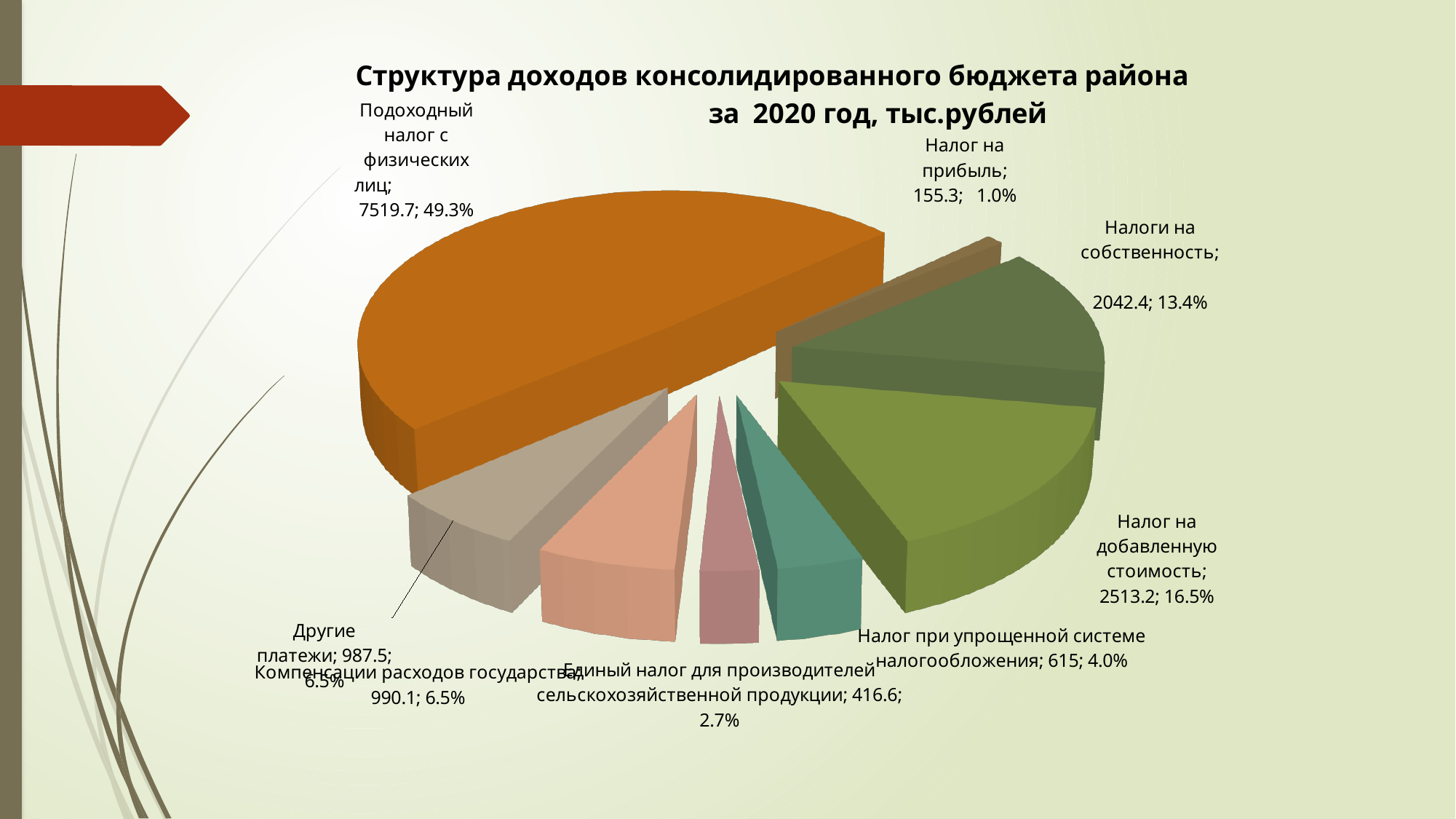
What share of the pie does Налог на прибыль take? 1.0% What is the difference between the values for Налог на добавленную стоимость and Налоги на собственность? 470.8 What share of the pie does Налог на добавленную стоимость take? 16.5% What is the value for Компенсации расходов государства? 990.1 What is the value for Подоходный налог с физических лиц? 7519.7 What is the value for Налоги на собственность? 2042.4 What kind of chart is shown on the slide? pie chart Which category has the smallest slice? Налог на прибыль Which is larger: Налог при упрощенной системе налогообложения or Единый налог для производителей сельскохозяйственной продукции? Налог при упрощенной системе налогообложения What is the title of the chart? Структура доходов консолидированного бюджета района за 2020 год, тыс.рублей How many slices does the pie chart have? 8 Which category has the largest slice? Подоходный налог с физических лиц